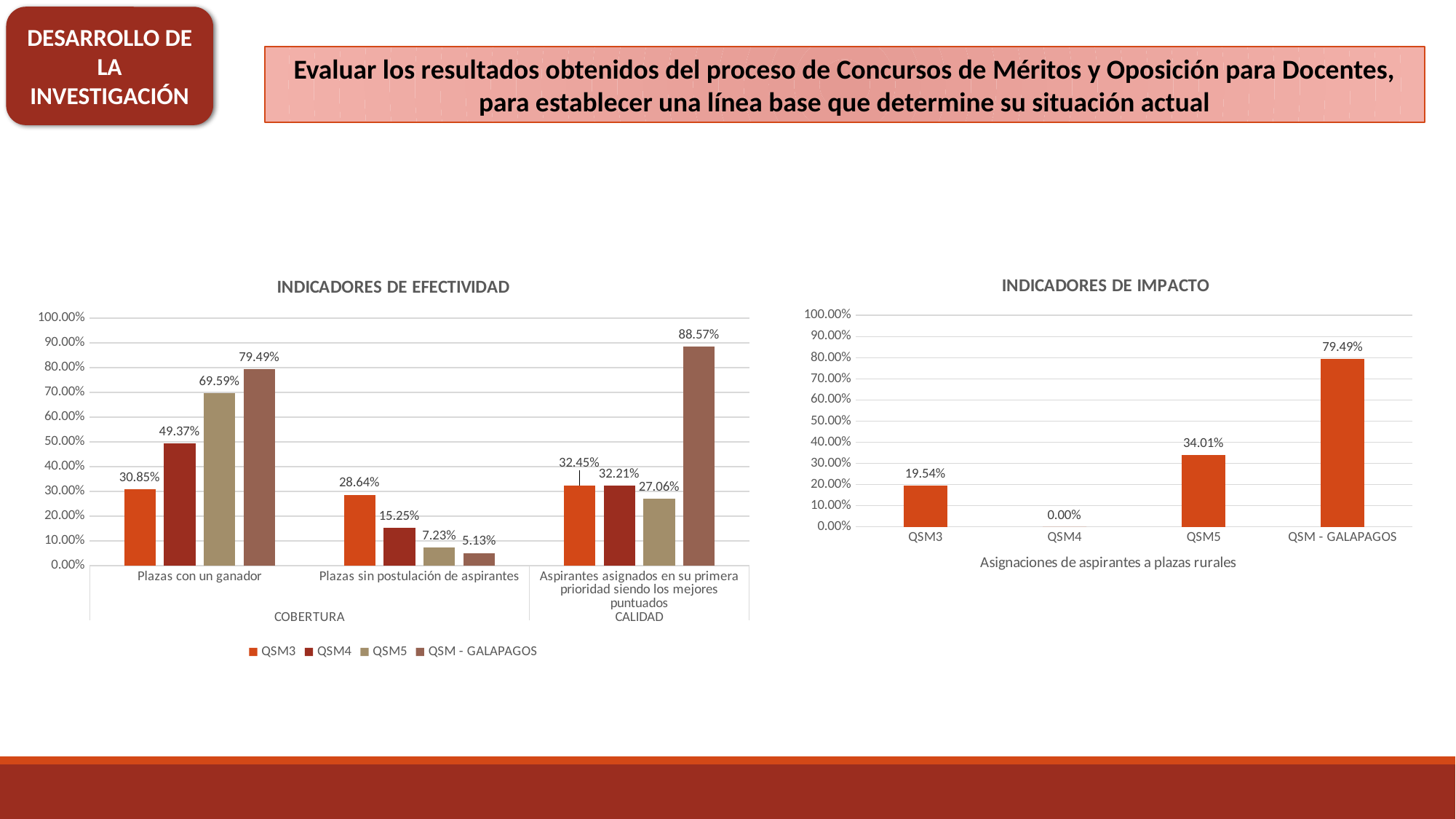
In the 'INDICADORES DE IMPACTO' chart, what is the value for QSM5? 34.01% In the 'INDICADORES DE EFECTIVIDAD' chart, what is the value for QSM4 in 'Plazas con un ganador'? 49.37% How many categories are shown on the x axis of the 'INDICADORES DE IMPACTO' chart? 4 In the 'INDICADORES DE EFECTIVIDAD' chart, what is the value for QSM - GALAPAGOS in 'Aspirantes asignados en su primera prioridad siendo los mejores puntuados'? 88.57% In the 'INDICADORES DE EFECTIVIDAD' chart, what is the difference between QSM5 and QSM3 in 'Plazas con un ganador'? 38.74% In the 'INDICADORES DE IMPACTO' chart, which category has the lowest value? QSM4 In the 'INDICADORES DE IMPACTO' chart, what is the difference between QSM - GALAPAGOS and QSM3? 59.95% In the 'INDICADORES DE EFECTIVIDAD' chart, which series has the highest value in 'Plazas con un ganador'? QSM - GALAPAGOS In the 'INDICADORES DE EFECTIVIDAD' chart, which is larger in 'Plazas sin postulación de aspirantes': QSM3 or QSM4? QSM3 How many series does the legend of the 'INDICADORES DE EFECTIVIDAD' chart list? 4 What kind of chart is 'INDICADORES DE IMPACTO'? Bar chart In the 'INDICADORES DE EFECTIVIDAD' chart, which series has the lowest value in 'Plazas sin postulación de aspirantes'? QSM - GALAPAGOS